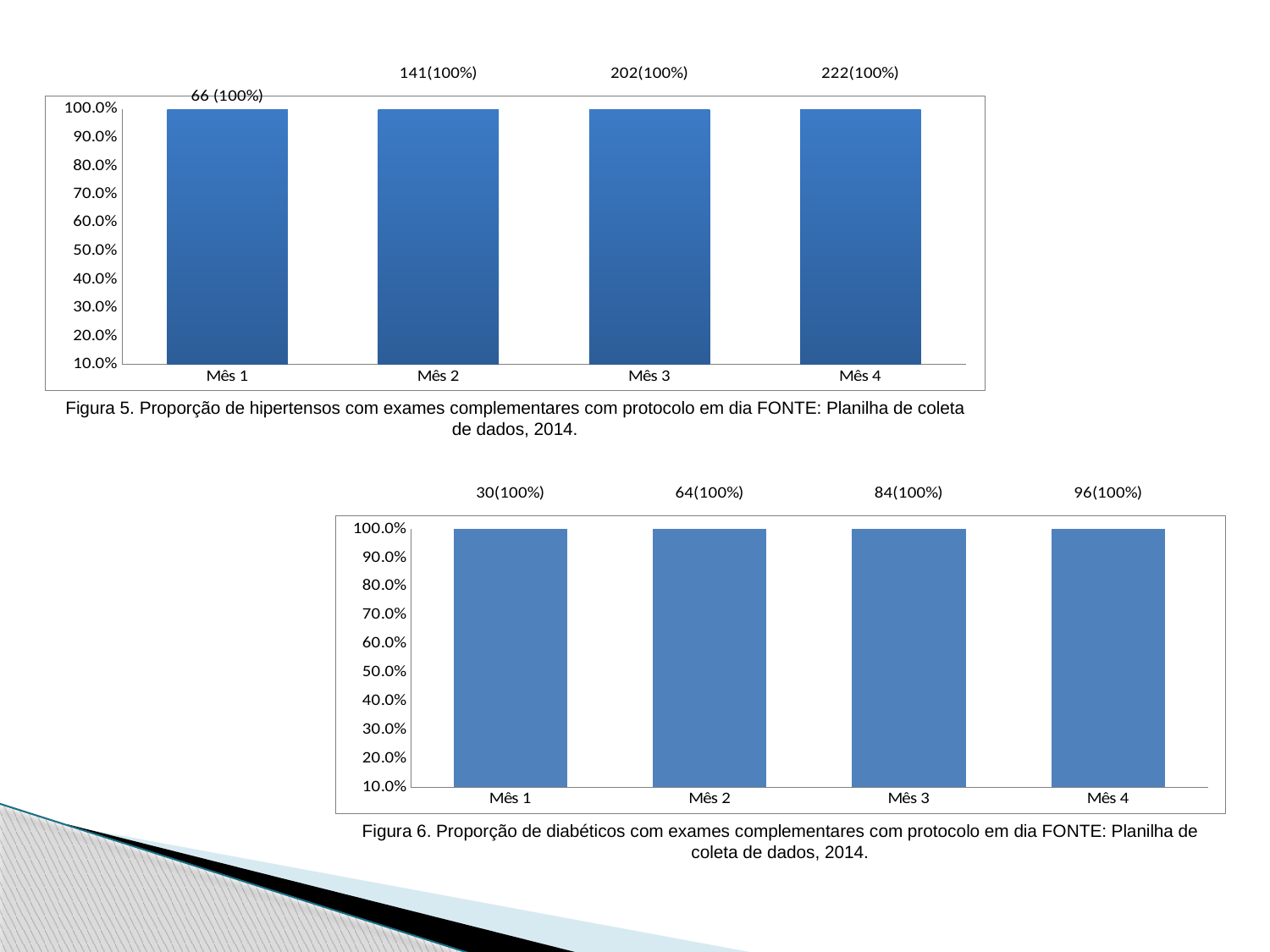
In the bottom chart (Figura 6), which month has the lowest count in its data label? Mês 1 In the top chart (Figura 5), how many categories are shown on the x axis? 4 In the top chart (Figura 5), what is the data label shown above the bar for Mês 2? 141(100%) In the bottom chart (Figura 6), what is the difference between the counts for Mês 4 and Mês 1 shown in the data labels? 66 What is the caption of the bottom chart? Figura 6. Proporção de diabéticos com exames complementares com protocolo em dia FONTE: Planilha de coleta de dados, 2014. In the top chart (Figura 5), what is the data label shown above the bar for Mês 4? 222(100%) In the top chart (Figura 5), which month has the highest count in its data label? Mês 4 What kind of chart is the top chart (Figura 5)? Bar chart In the bottom chart (Figura 6), how many bars are plotted? 4 In the bottom chart (Figura 6), what is the data label shown above the bar for Mês 3? 84(100%) In the top chart (Figura 5), is the bar for Mês 3 greater or less than 50.0%? greater In the bottom chart (Figura 6), what is the data label shown above the bar for Mês 1? 30(100%)